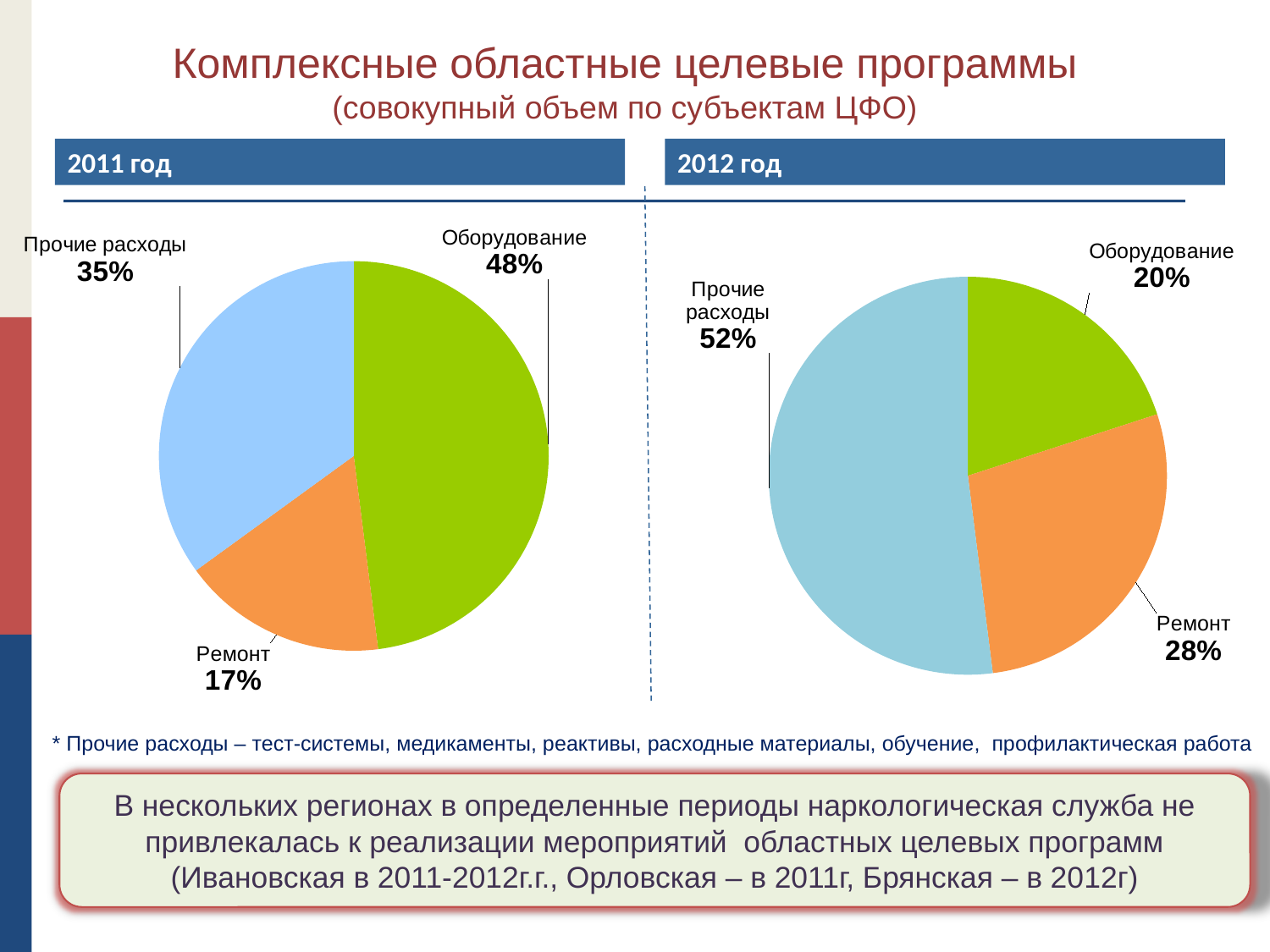
What type of chart is used for the 2011 год data? Pie chart In the 2012 год pie chart, what is the difference between the shares of Прочие расходы and Ремонт? 24% In the 2011 год pie chart, which category has the largest share? Оборудование In the 2012 год pie chart, what share is Прочие расходы? 52% How many slices does the 2012 год pie chart have? 3 In the 2011 год pie chart, what is the difference between the shares of Оборудование and Прочие расходы? 13% In the 2012 год pie chart, which category has the smallest share? Оборудование Which is larger: the share of Ремонт in the 2011 год chart or in the 2012 год chart? 2012 год In the 2011 год pie chart, what colour is the Ремонт slice? Orange In the 2012 год pie chart, what share is Ремонт? 28% In the 2011 год pie chart, what share is Ремонт? 17% In the 2011 год pie chart, what share is Оборудование? 48%